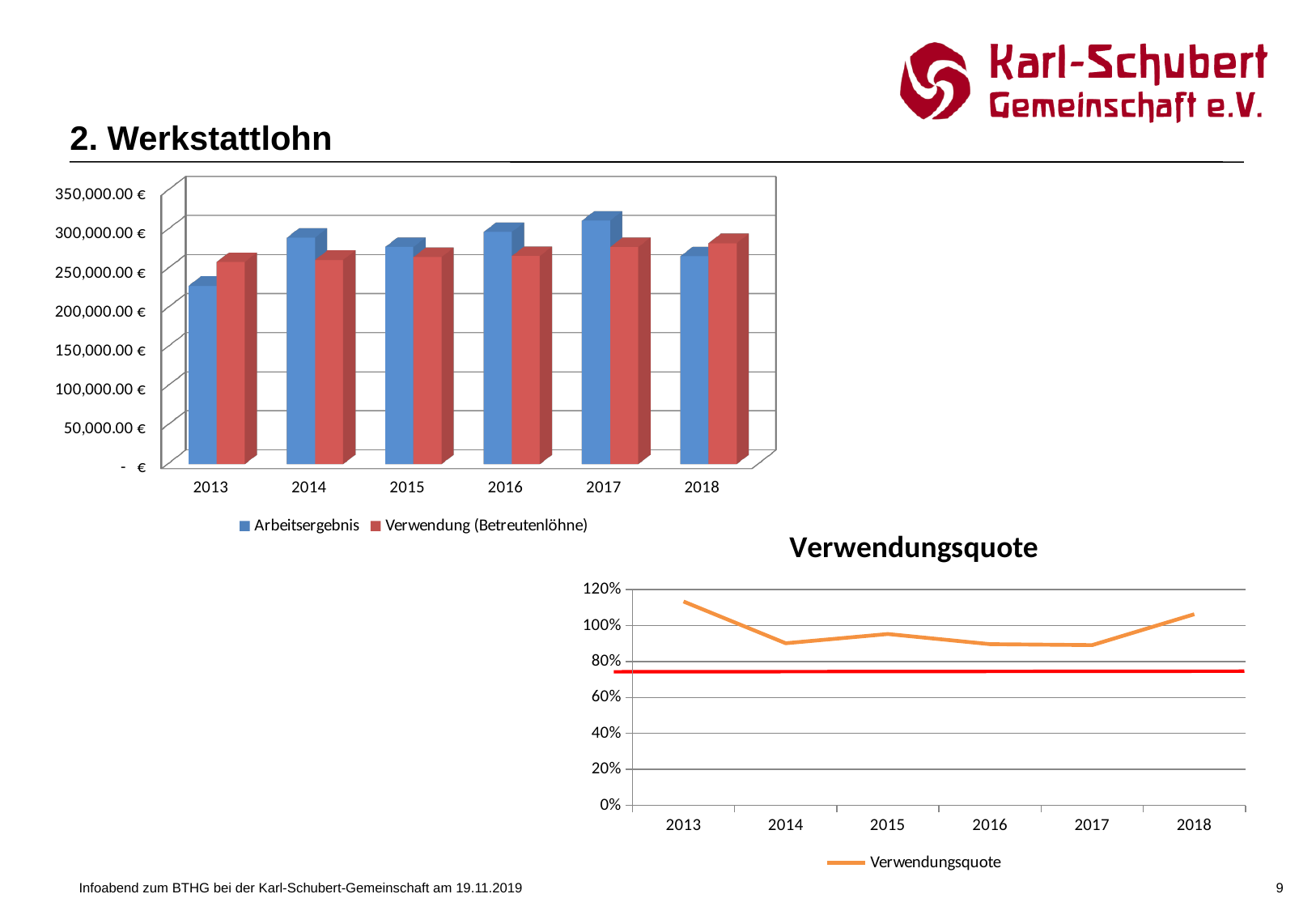
In the bar chart at the top left, which is larger for 2018: Arbeitsergebnis or Verwendung (Betreutenlöhne)? Verwendung (Betreutenlöhne) In the 'Verwendungsquote' chart, how many years are plotted on the x axis? 6 In the 'Verwendungsquote' chart, which year has the highest Verwendungsquote? 2013 In the bar chart at the top left, which year has the lowest Arbeitsergebnis? 2013 What kind of chart is the 'Verwendungsquote' chart? line chart In the bar chart at the top left, is the Arbeitsergebnis for 2013 greater or less than 250,000.00 €? less In the bar chart at the top left, how many series does the legend list? 2 In the bar chart at the top left, is the Arbeitsergebnis for 2017 greater or less than 300,000.00 €? greater What kind of chart is the chart at the top left of the slide? bar chart In the 'Verwendungsquote' chart, is the value for 2014 greater or less than 100%? less In the bar chart at the top left, which is larger for 2017: Arbeitsergebnis or Verwendung (Betreutenlöhne)? Arbeitsergebnis In the bar chart at the top left, which year has the highest Arbeitsergebnis? 2017